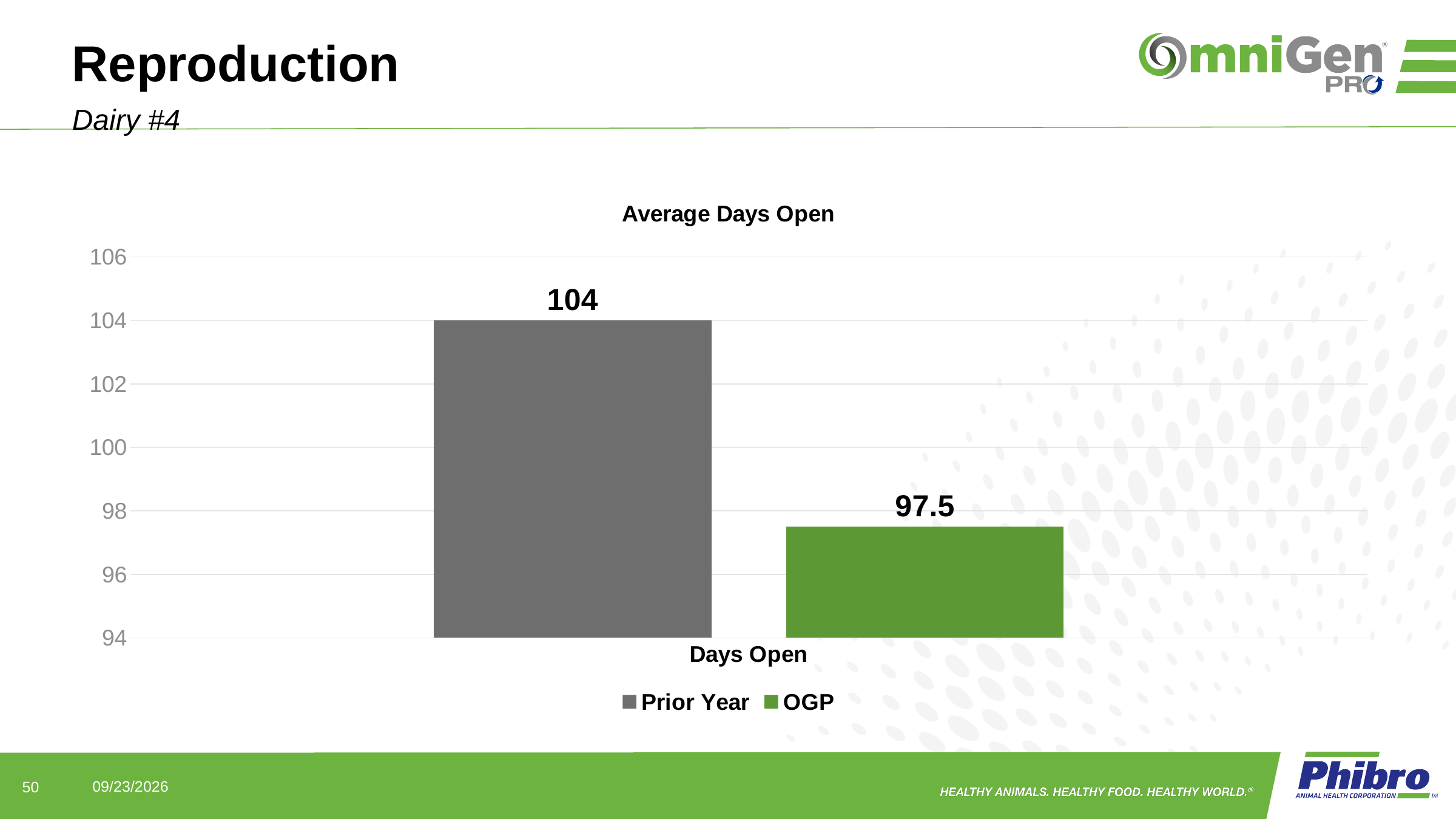
Is the OGP value for Days Open greater or less than 100? less What is the Prior Year value for Days Open? 104 What is the OGP value for Days Open? 97.5 How many series does the legend list? 2 Which series has the lowest value in the chart? OGP Which series has the higher value for Days Open, Prior Year or OGP? Prior Year What is the difference between the Prior Year and OGP values for Days Open? 6.5 What colour is the OGP bar? Green What kind of chart is shown on the slide? Bar chart What is the title of the chart? Average Days Open How many bars are plotted in the chart? 2 Is the Prior Year value for Days Open greater or less than 102? greater